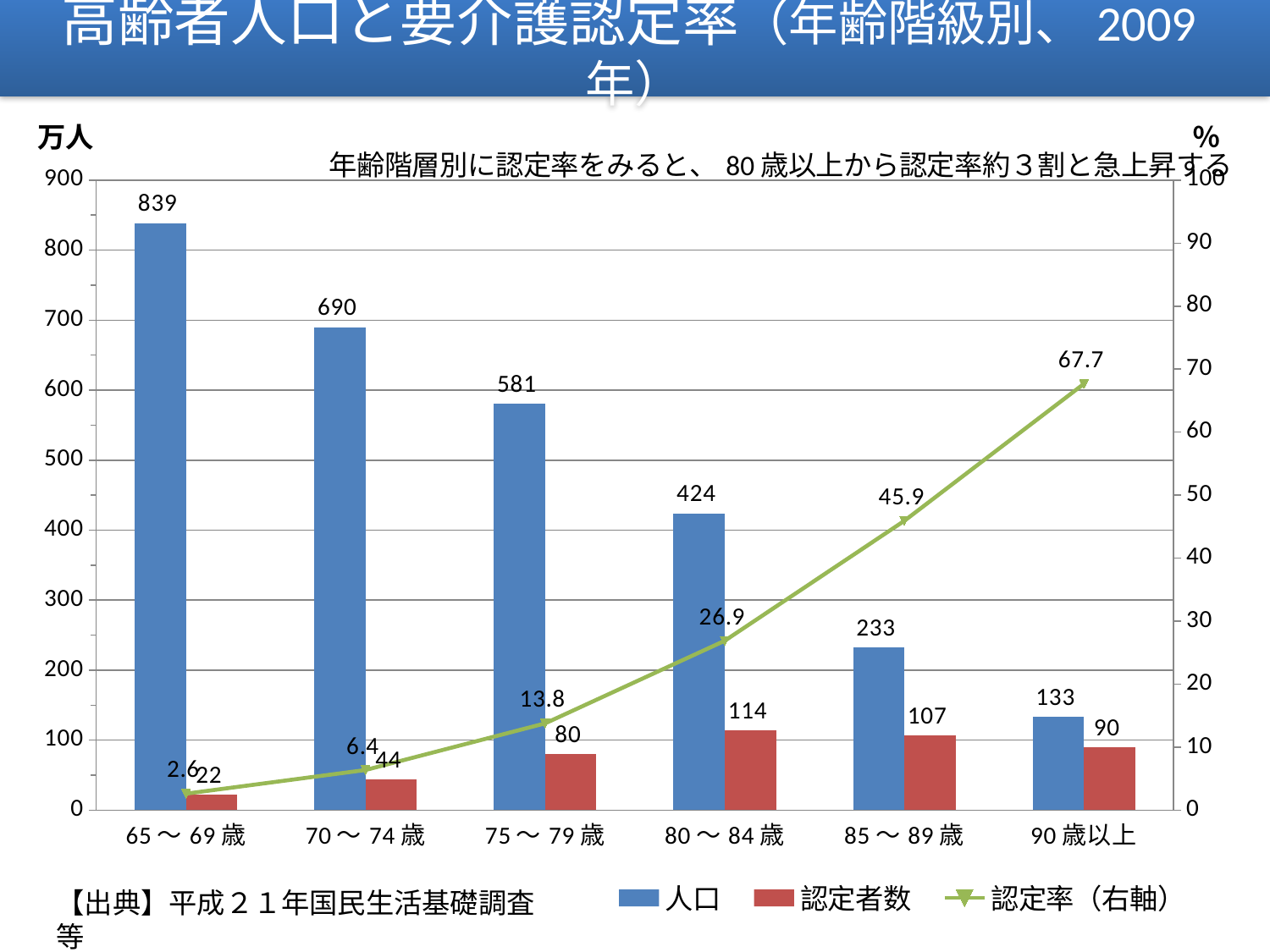
Does the 認定率 series rise or fall as the age groups increase along the x axis? rise Which age group has the lowest 人口? 90歳以上 Does the 人口 series rise or fall as the age groups increase along the x axis? fall Which is larger, the 認定者数 for 85～89歳 or for 90歳以上? 85～89歳 Which series is plotted on the right axis according to the legend? 認定率（右軸） What is the difference between the 人口 values for 65～69歳 and 70～74歳? 149 How many series does the legend list? 3 What is the 人口 value for the 65～69歳 age group? 839 How many age groups are shown on the x axis? 6 What is the 認定率 (right axis) value for the 90歳以上 age group? 67.7 Which age group has the highest 認定者数? 80～84歳 What is the 認定者数 value for the 80～84歳 age group? 114